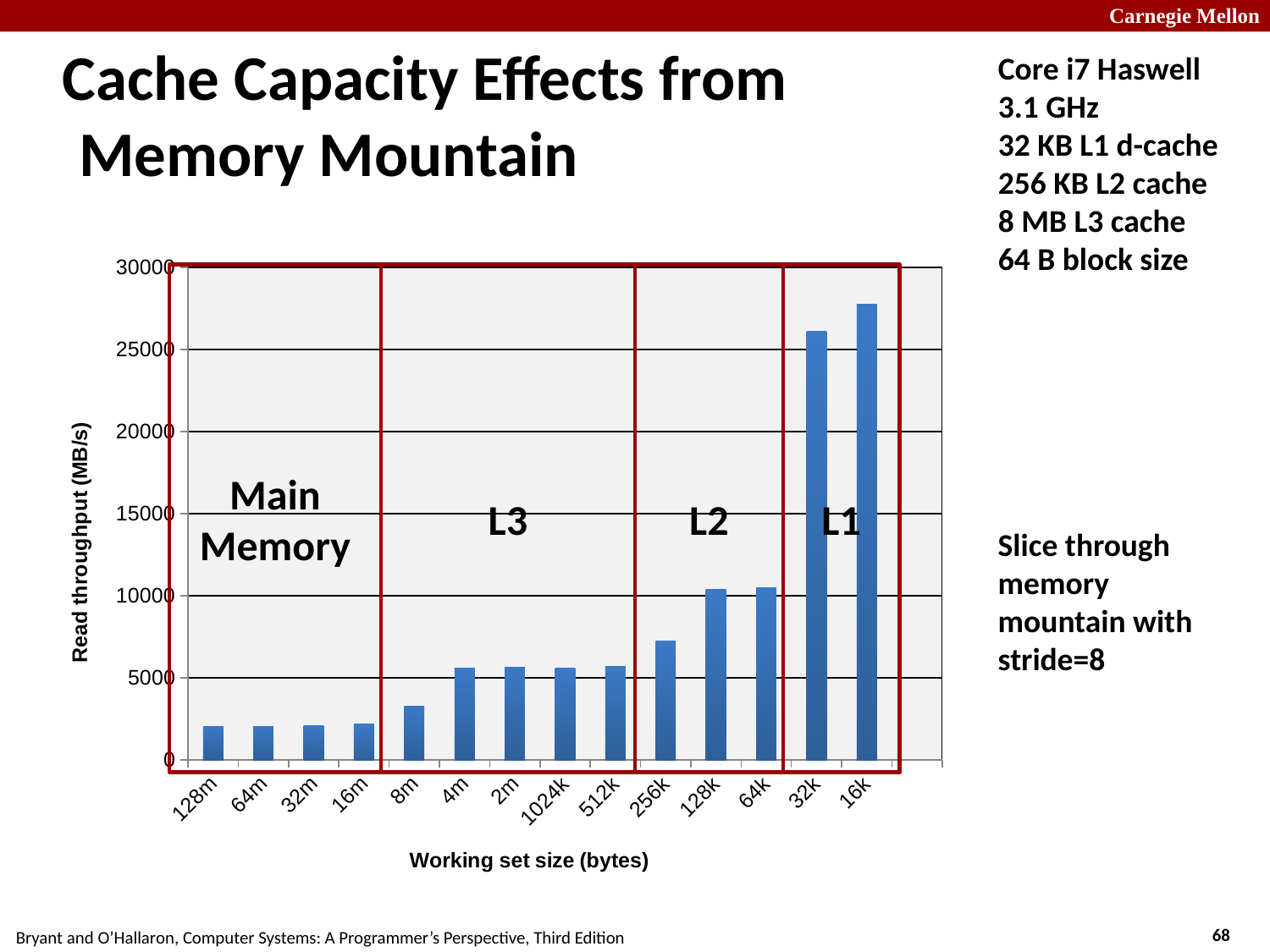
Which has the higher read throughput, a working set size of 256k or 512k? 256k Which has the higher read throughput, a working set size of 16k or 32k? 16k What is the label of the y axis? Read throughput (MB/s) Is the read throughput for a working set size of 16k greater or less than 25000? greater Which working set size has the highest read throughput? 16k Is the read throughput for a working set size of 256k greater or less than 10000? less Is the read throughput for a working set size of 4m greater or less than 5000? greater What kind of chart is shown on the slide? bar chart Do the bars generally rise or fall moving from left to right along the x axis? rise How many working set sizes are plotted along the x axis? 14